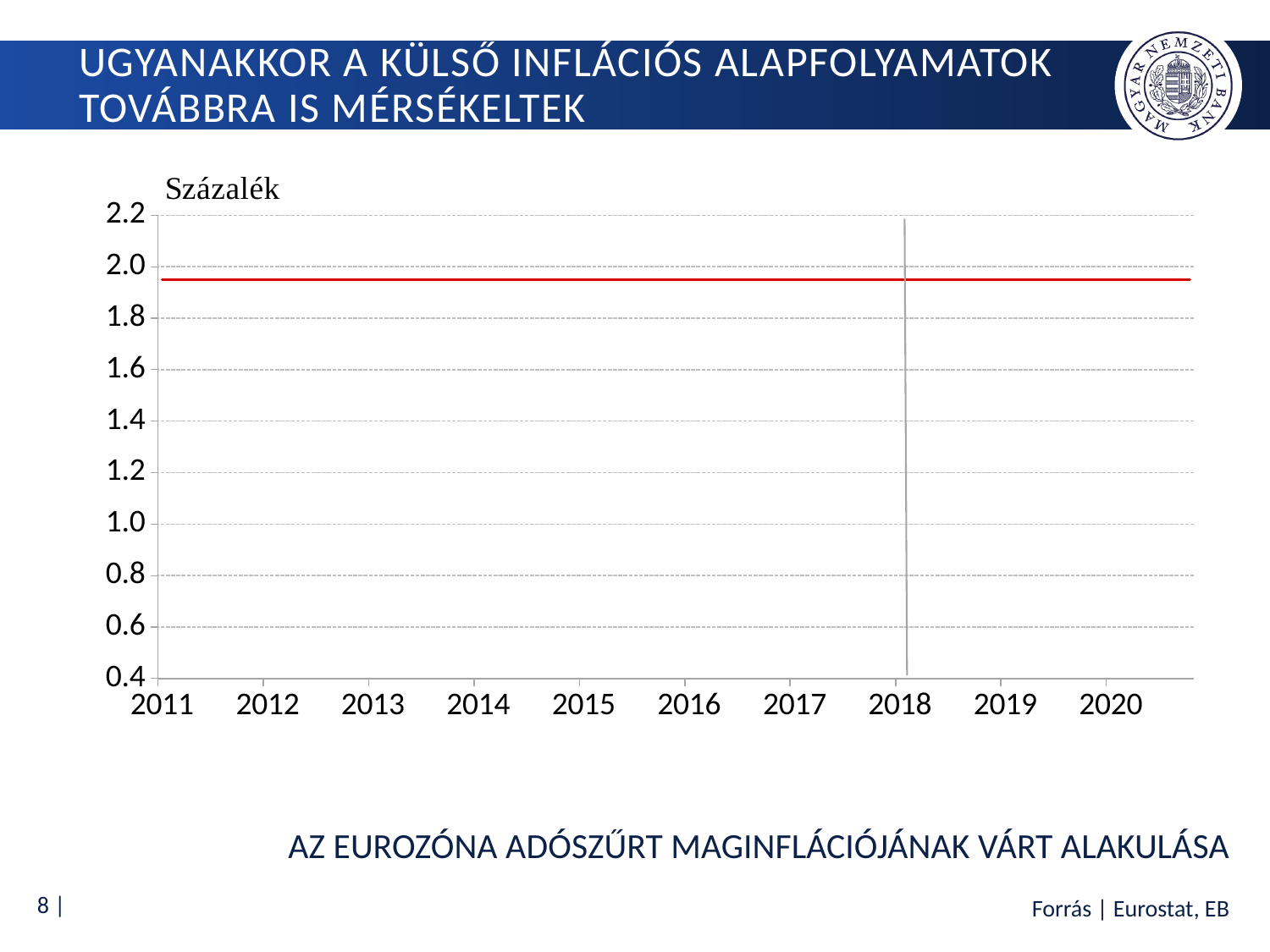
How many years are labelled on the x axis? 10 Is the value of the red line in 2019 greater or less than 2.0? less Does the red line rise, fall or stay flat from 2011 to 2020? stays flat At which year is the vertical grey line drawn? 2018 Is the value of the red line in 2012 greater or less than 1.0? greater What unit is shown above the y axis? Százalék What kind of chart is shown on the slide? line chart Is the value of the red line in 2015 greater or less than 1.8? greater What is the highest value shown on the y axis? 2.2